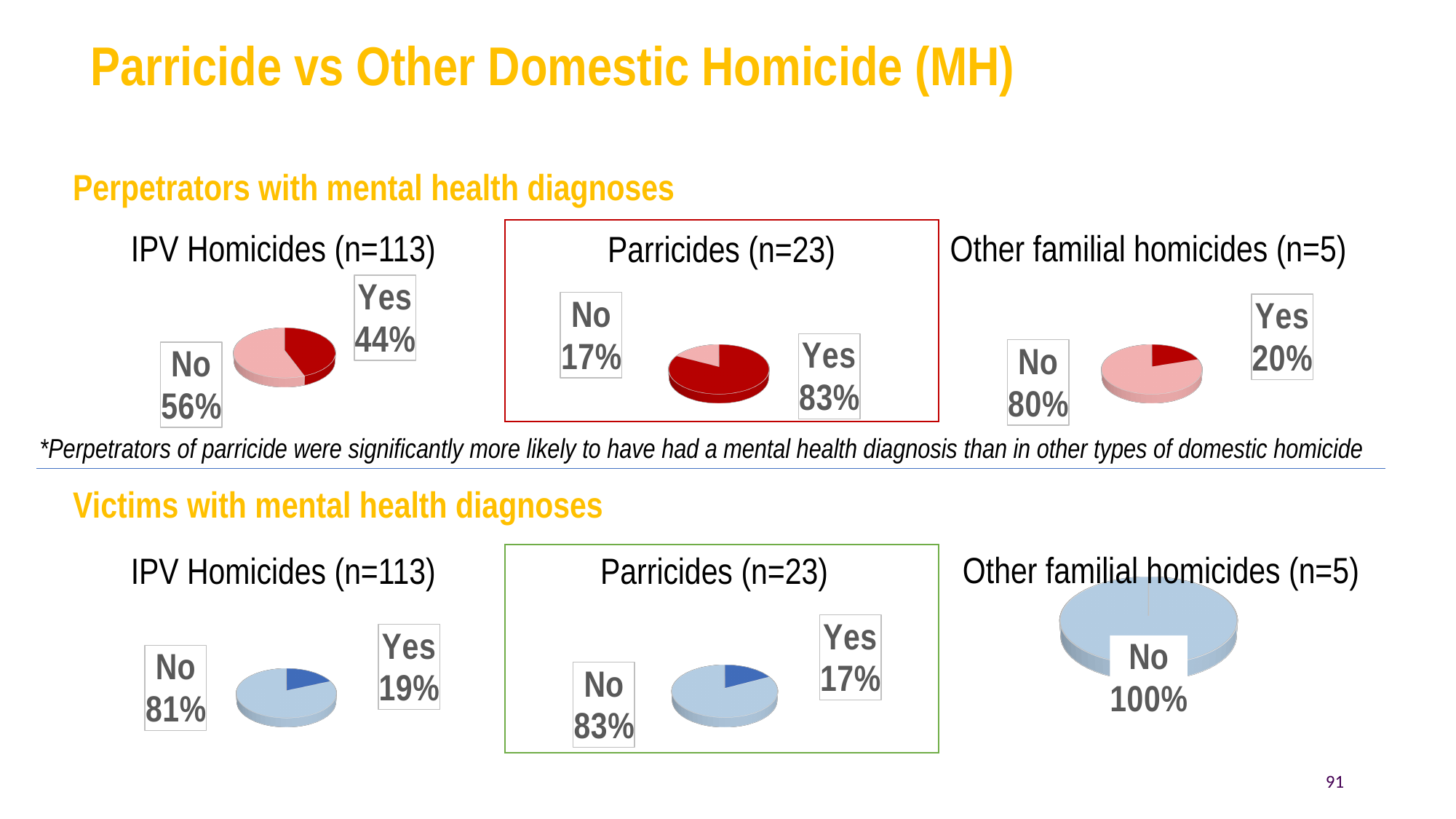
In the Perpetrators with mental health diagnoses row, what share of the IPV Homicides (n=113) pie is 'No'? 56% What type of chart is used for the Parricides (n=23) data in the Perpetrators with mental health diagnoses row? Pie chart In the Perpetrators with mental health diagnoses row, what share of the Parricides (n=23) pie is 'Yes'? 83% In the Perpetrators with mental health diagnoses row, which slice is larger in the IPV Homicides (n=113) pie, 'Yes' or 'No'? No In the Perpetrators with mental health diagnoses row, what share of the Other familial homicides (n=5) pie is 'Yes'? 20% In the Perpetrators with mental health diagnoses row, which slice is larger in the Parricides (n=23) pie, 'Yes' or 'No'? Yes In the Victims with mental health diagnoses row, what share of the Parricides (n=23) pie is 'No'? 83% In the Victims with mental health diagnoses row, what is the difference between the 'No' share for Parricides (n=23) and the 'No' share for IPV Homicides (n=113)? 2% How many pie charts are shown on the slide in total? 6 In the Perpetrators with mental health diagnoses row, what is the difference between the 'Yes' share for Parricides (n=23) and the 'Yes' share for IPV Homicides (n=113)? 39% In the Victims with mental health diagnoses row, what share of the IPV Homicides (n=113) pie is 'Yes'? 19% In the Victims with mental health diagnoses row, what share of the Other familial homicides (n=5) pie is 'No'? 100%